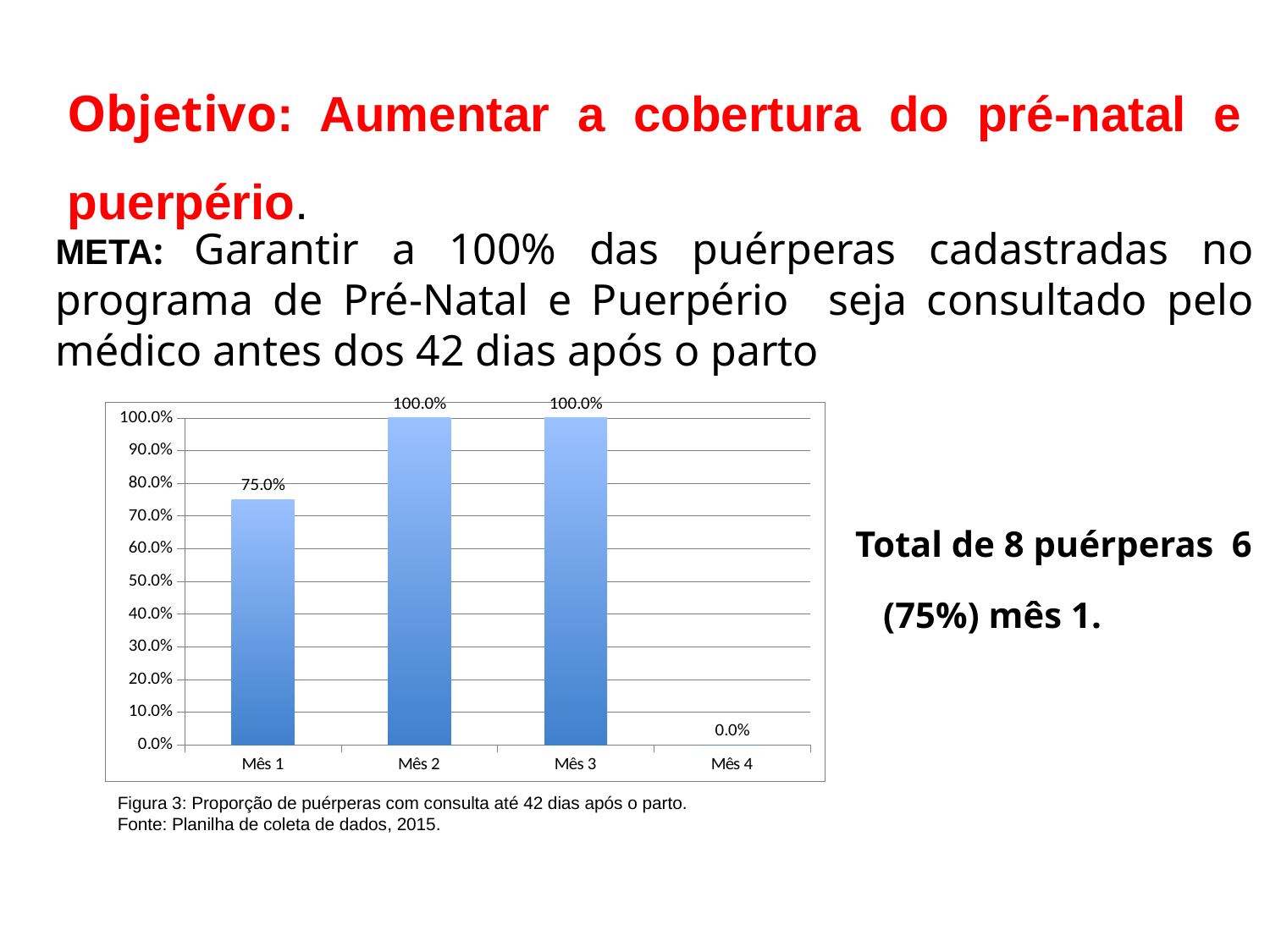
What is the value for Mês 4? 0.0% What is the figure caption below the chart? Figura 3: Proporção de puérperas com consulta até 42 dias após o parto. Which is larger, the value for Mês 1 or the value for Mês 3? Mês 3 What is the value for Mês 2? 100.0% Which category has the lowest value? Mês 4 Is the value for Mês 1 greater or less than 80.0%? less What is the highest value shown on the y axis? 100.0% Does the value rise or fall from Mês 3 to Mês 4? fall What is the difference between the values for Mês 2 and Mês 1? 25.0% What is the value for Mês 1? 75.0% How many categories are shown on the x axis? 4 What kind of chart is shown on the slide? bar chart